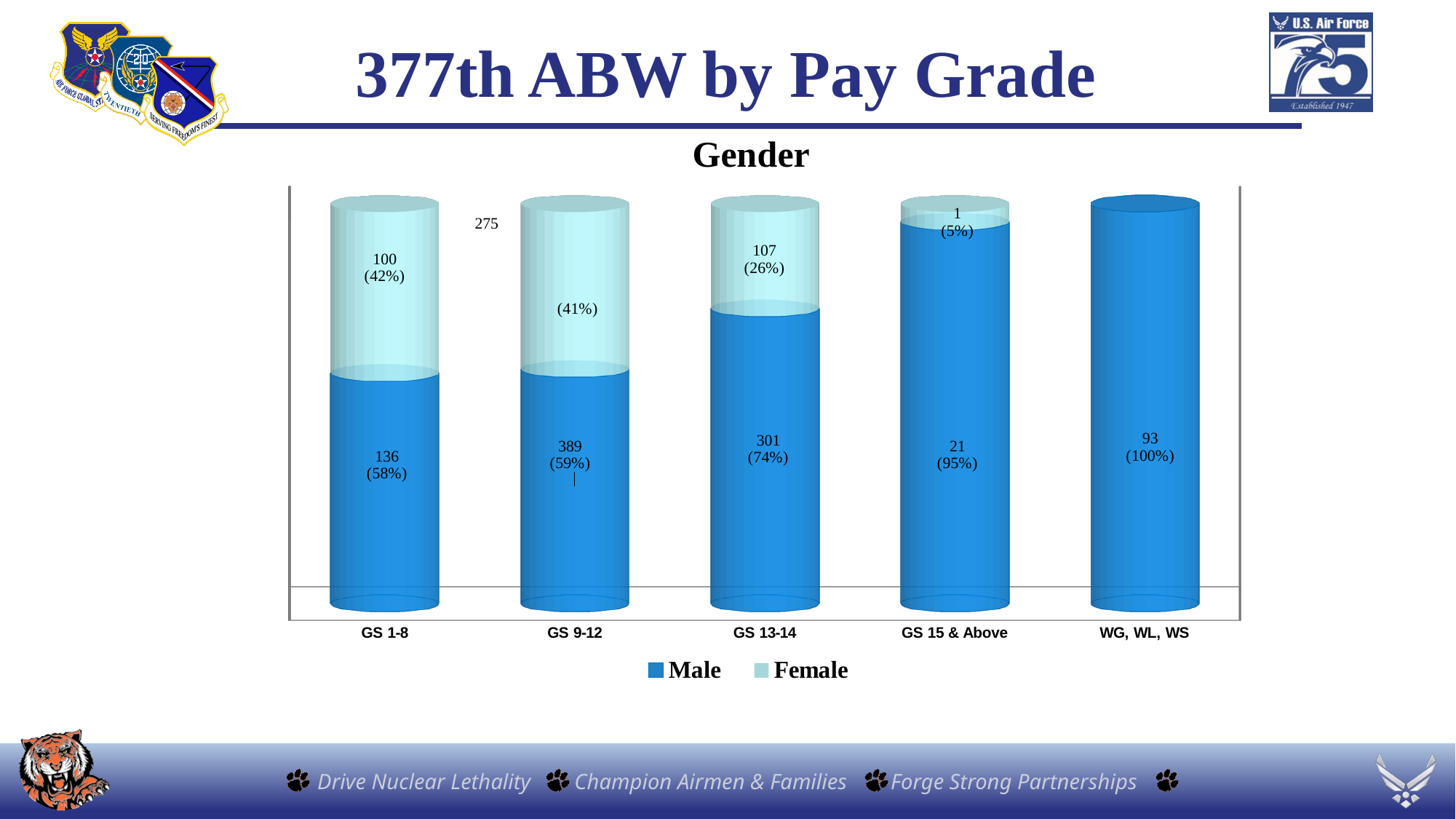
What is the Female count for GS 15 & Above? 1 What percentage of GS 9-12 is Female? 41% Which pay grade has the lowest Male count? GS 15 & Above How many series does the legend list? 2 What percentage of GS 1-8 is Female? 42% What is the Male count for GS 13-14? 301 What is the total count (Male plus Female) for GS 1-8? 236 What kind of chart is shown? Stacked bar chart How many pay grade categories are shown on the x axis? 5 Which pay grade has the highest Male count? GS 9-12 What is the difference between the Male and Female counts for GS 13-14? 194 Which is larger, the Male count for GS 1-8 or the Male count for WG, WL, WS? GS 1-8